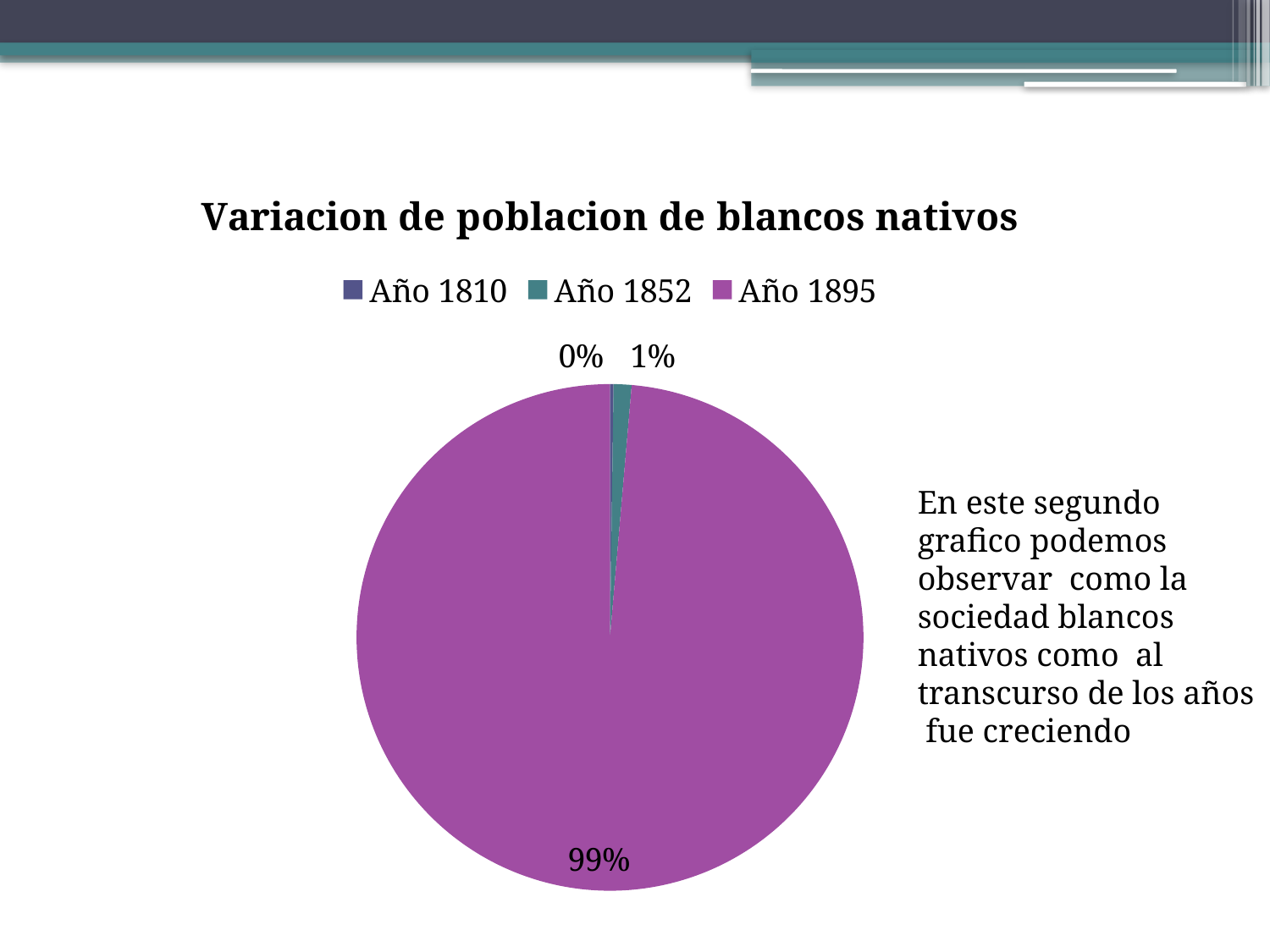
Which is larger, the slice for Año 1852 or the slice for Año 1895? Año 1895 What percentage of the pie does Año 1895 represent? 99% Which year has the smallest slice of the pie? Año 1810 What colour is the slice for Año 1895? purple How many entries does the legend list? 3 What percentage of the pie does Año 1852 represent? 1% What is the difference in percentage points between the Año 1895 slice and the Año 1852 slice? 98% What percentage of the pie does Año 1810 represent? 0% What type of chart is shown on the slide? pie chart How many slices does the pie chart have? 3 Which year has the largest slice of the pie? Año 1895 What is the title of the chart? Variacion de poblacion de blancos nativos